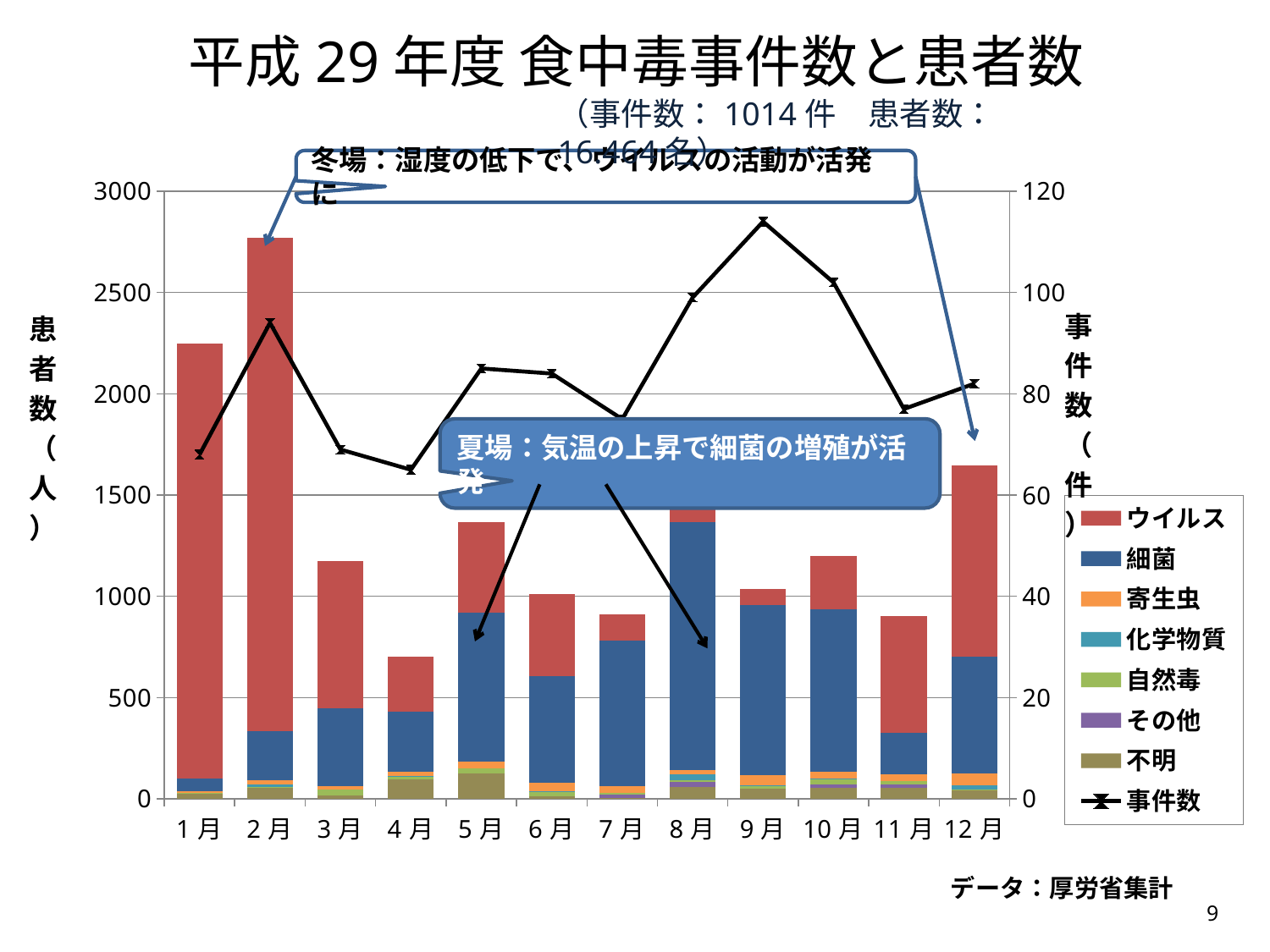
Is the total patient number (患者数) for 2月 greater or less than 2500? greater What is the title of the chart on the slide? 平成29年度 食中毒事件数と患者数 How many months (categories) are shown along the x axis? 12 Which month has the larger total patient number (患者数), 8月 or 7月? 8月 Which month has the shortest stacked bar for patient numbers (患者数)? 4月 How many series does the chart legend list? 8 What colour represents the ウイルス series in the chart? red What kind of chart is used to show the monthly patient numbers (患者数)? stacked bar chart Is the total patient number (患者数) for 4月 greater or less than 1000? less Is the 事件数 value for 9月 greater or less than 100? greater In which month does the 事件数 line reach its highest point? 9月 Which month has the tallest stacked bar for patient numbers (患者数)? 2月